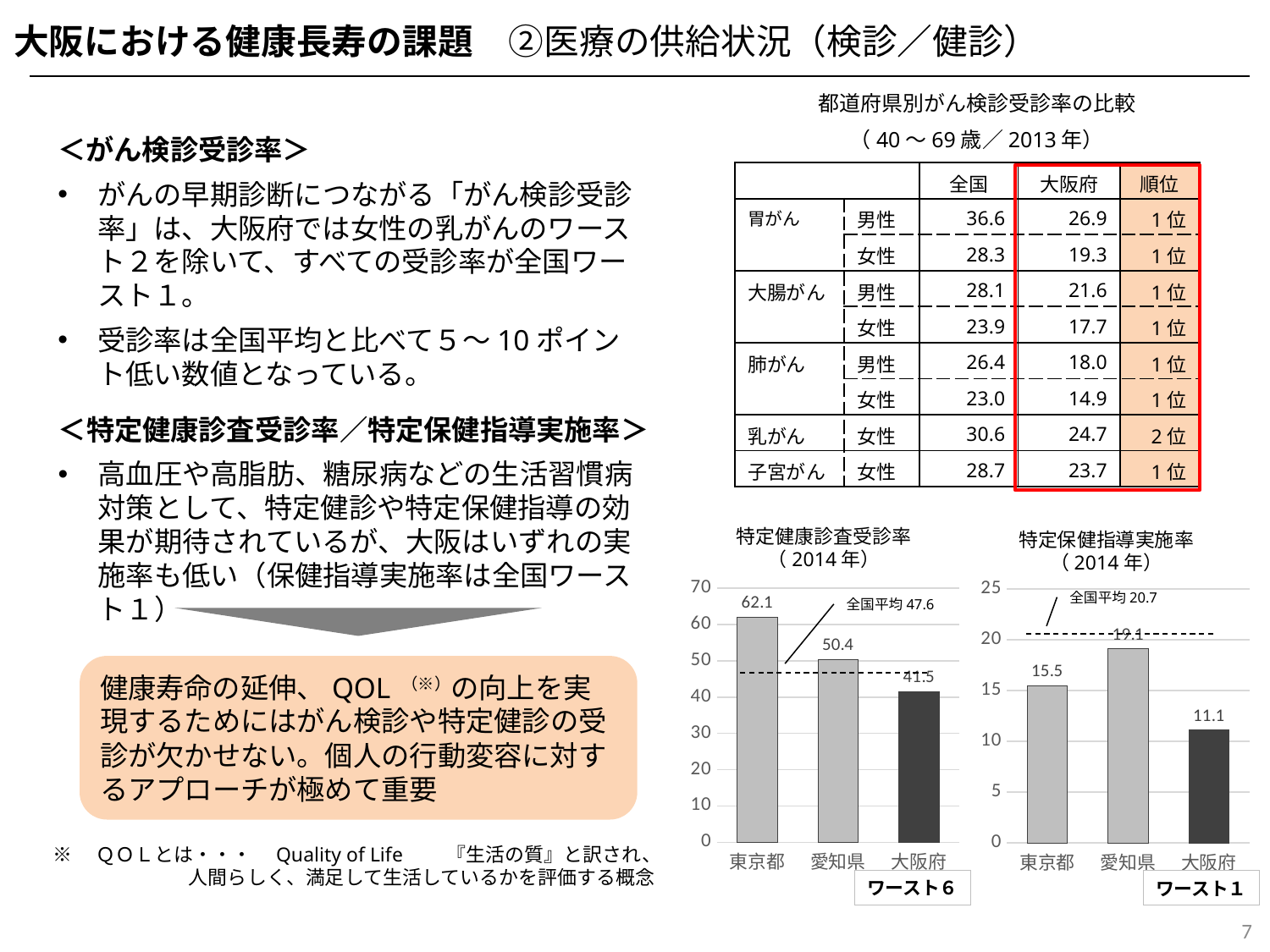
In the 特定保健指導実施率（2014年） chart, what is the difference between 愛知県 and 大阪府? 8.0 In the 特定健康診査受診率（2014年） chart, what is the value for 大阪府? 41.5 In the 特定保健指導実施率（2014年） chart, what is the value for 大阪府? 11.1 In the 特定健康診査受診率（2014年） chart, what is the value for 東京都? 62.1 In the 特定保健指導実施率（2014年） chart, which is larger, 東京都 or 大阪府? 東京都 How many prefectures are plotted in the 特定保健指導実施率（2014年） chart? 3 In the 特定保健指導実施率（2014年） chart, which prefecture has the highest value? 愛知県 In the 特定健康診査受診率（2014年） chart, what is the difference between 東京都 and 大阪府? 20.6 In the 特定健康診査受診率（2014年） chart, which prefecture has the lowest value? 大阪府 In the 特定健康診査受診率（2014年） chart, what national average (全国平均) is shown? 47.6 In the 特定保健指導実施率（2014年） chart, what is the value for 愛知県? 19.1 In the 特定健康診査受診率（2014年） chart, which prefecture has the highest value? 東京都